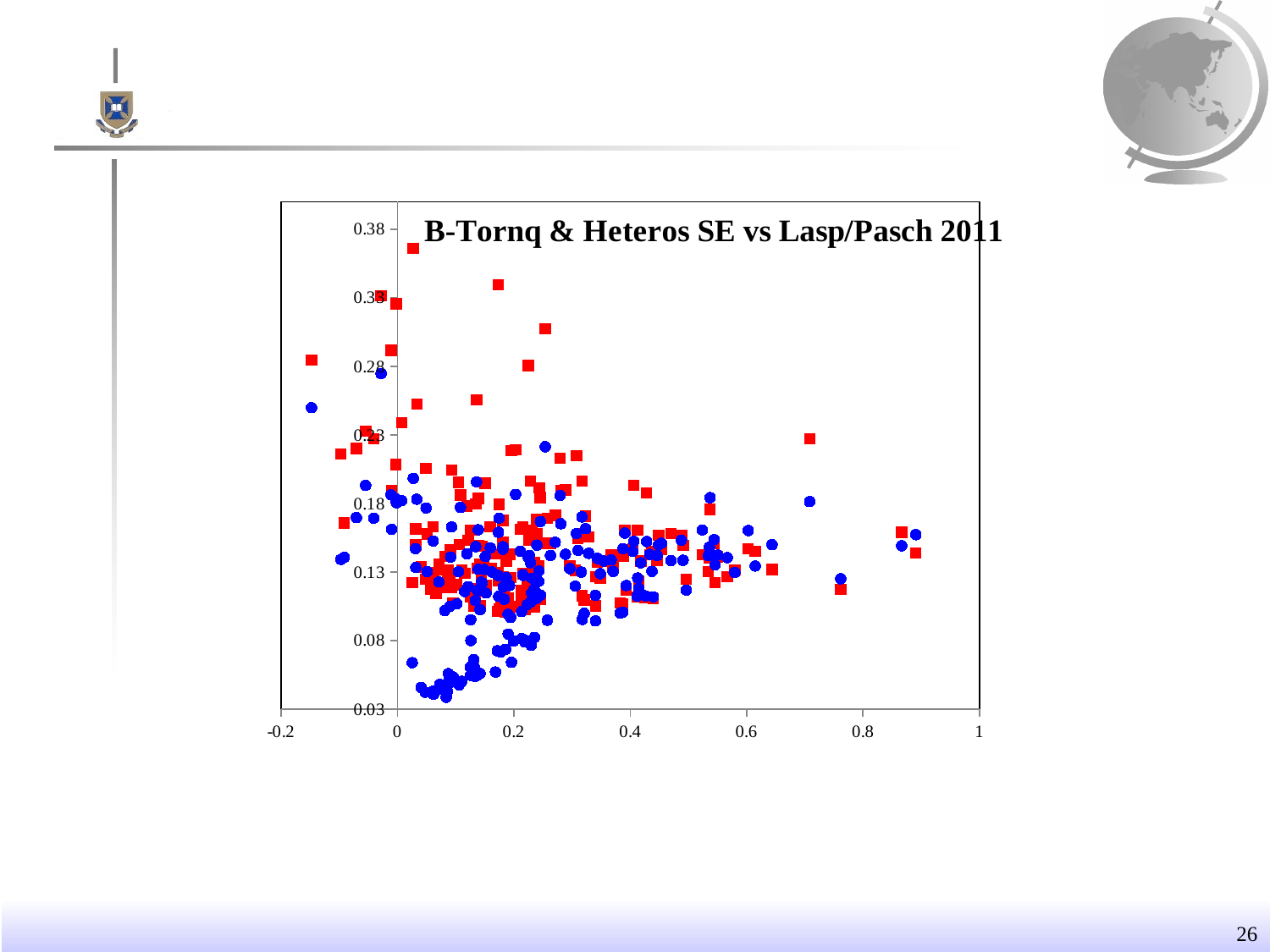
Is the highest blue point in the chart greater or less than 0.33 on the y axis? less Are the rightmost points in the chart (near x = 0.9) greater or less than 0.18 on the y axis? less What is the title of the chart? B-Tornq & Heteros SE vs Lasp/Pasch 2011 Which series reaches the highest y value in the chart, the red squares or the blue circles? red squares Which series reaches the lowest y value in the chart, the red squares or the blue circles? blue circles Is the highest red point in the chart greater or less than 0.33 on the y axis? greater What kind of chart is shown on the slide? scatter chart What two marker colours are used for the plotted points? red and blue How many data series are plotted in the chart? 2